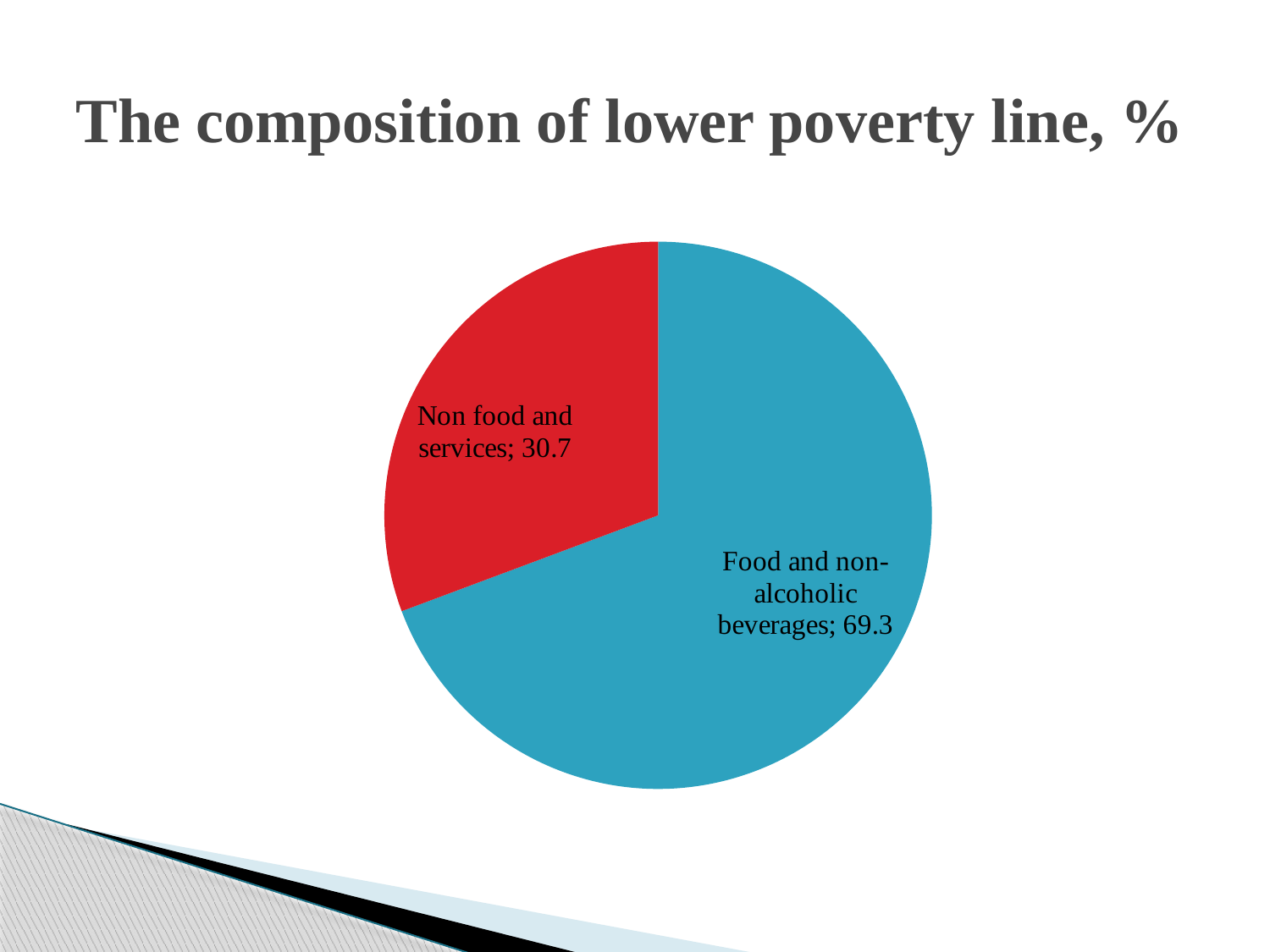
What is the value for Food and non-alcoholic beverages? 69.3 What is the title of the chart? The composition of lower poverty line, % What is the difference between the values for Food and non-alcoholic beverages and Non food and services? 38.6 What is the value for Non food and services? 30.7 Which category has the smallest share of the pie? Non food and services What is the total of the two slice values? 100 Which category has the largest share of the pie? Food and non-alcoholic beverages What kind of chart is shown on the slide? pie chart How many slices does the pie chart have? 2 What colour is the slice for Non food and services? red Which is larger: Food and non-alcoholic beverages or Non food and services? Food and non-alcoholic beverages